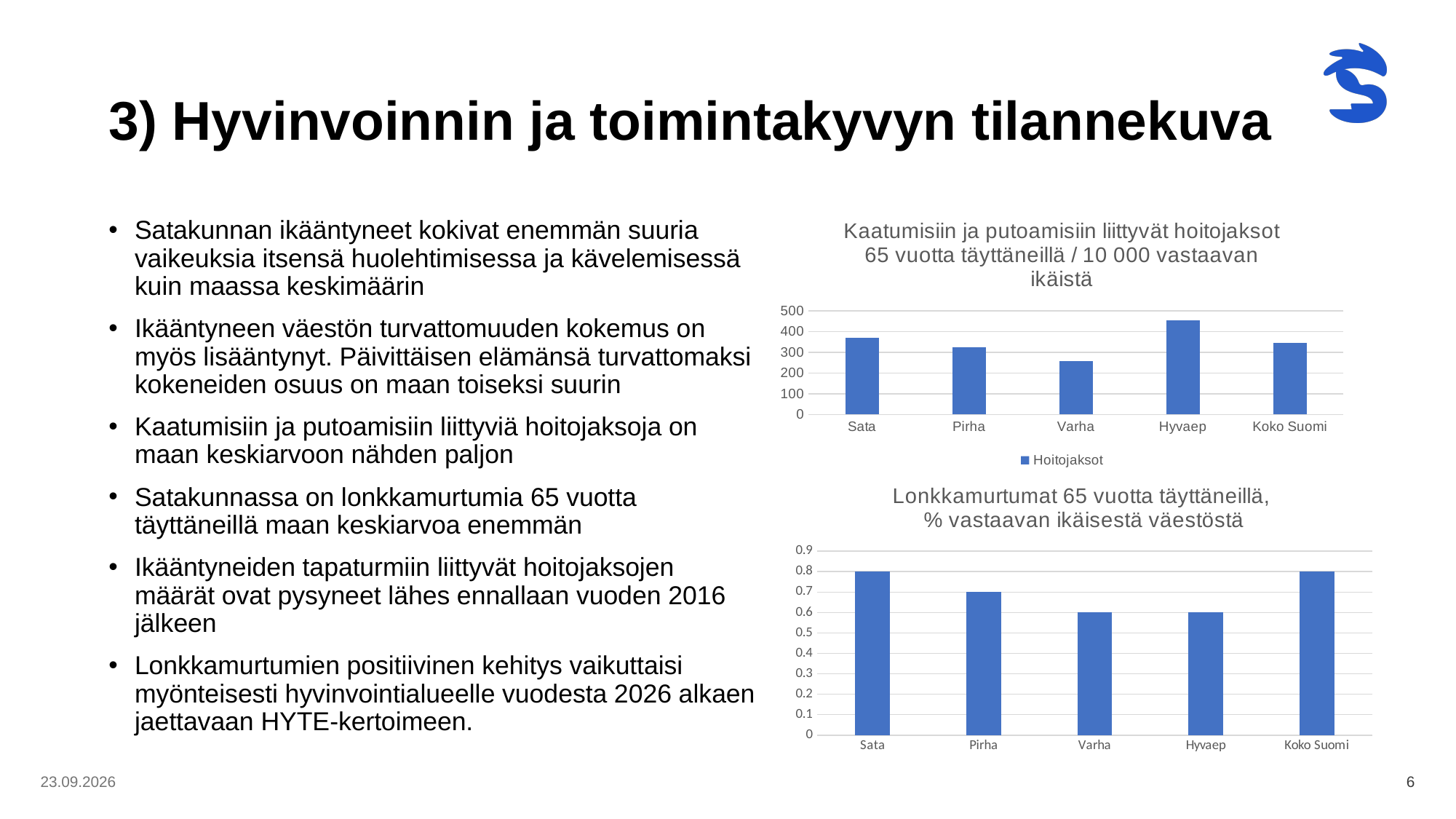
What type of chart is the bottom chart (Lonkkamurtumat 65 vuotta täyttäneillä)? bar chart In the bottom chart (Lonkkamurtumat 65 vuotta täyttäneillä), what is the value for Varha? 0.6 In the bottom chart (Lonkkamurtumat 65 vuotta täyttäneillä), what is the value for Pirha? 0.7 In the top chart (Kaatumisiin ja putoamisiin liittyvät hoitojaksot), is the value for Hyvaep greater or less than 400? greater In the top chart (Kaatumisiin ja putoamisiin liittyvät hoitojaksot), which category has the lowest value? Varha In the top chart (Kaatumisiin ja putoamisiin liittyvät hoitojaksot), which is larger, the value for Sata or the value for Pirha? Sata In the bottom chart (Lonkkamurtumat 65 vuotta täyttäneillä), what is the difference between the values for Sata and Varha? 0.2 In the top chart (Kaatumisiin ja putoamisiin liittyvät hoitojaksot), what series name does the legend show? Hoitojaksot In the top chart (Kaatumisiin ja putoamisiin liittyvät hoitojaksot), is the value for Varha greater or less than 300? less In the bottom chart (Lonkkamurtumat 65 vuotta täyttäneillä), what is the value for Sata? 0.8 In the top chart (Kaatumisiin ja putoamisiin liittyvät hoitojaksot), which category has the highest value? Hyvaep In the top chart (Kaatumisiin ja putoamisiin liittyvät hoitojaksot), how many categories are shown on the x axis? 5